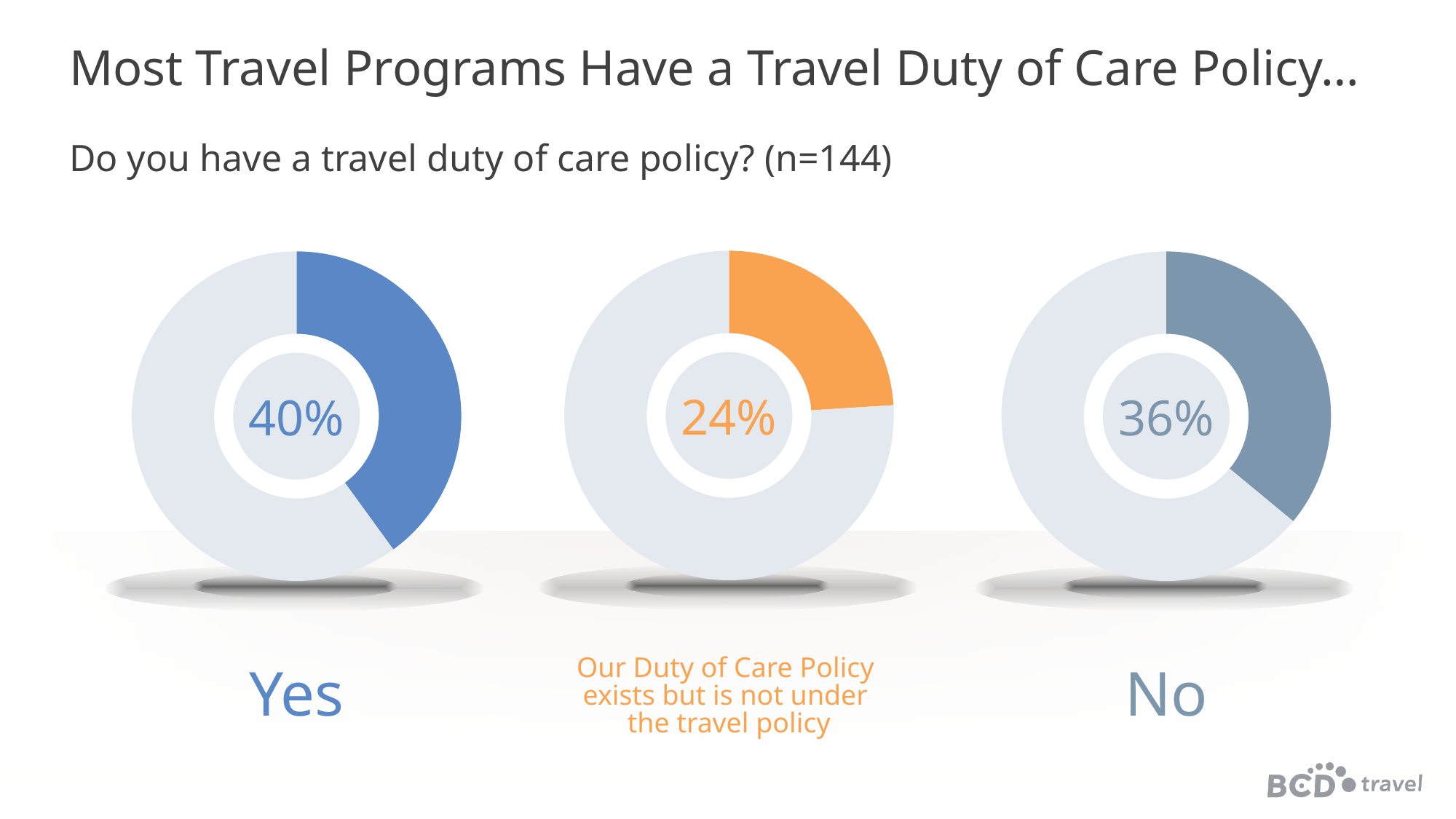
What is the difference in percentage points between the "Yes" and "No" responses? 4 What percentage of respondents answered "Yes" to having a travel duty of care policy? 40% What percentage of respondents answered "No"? 36% How many response options are shown on the slide? 3 What percentage said their Duty of Care Policy exists but is not under the travel policy? 24% What is the difference in percentage points between the "No" response and the "exists but is not under the travel policy" response? 12 Which response option has the highest percentage? Yes What kind of chart is used to show each response? Donut (pie) chart How many respondents (n) answered the survey question? 144 Which is larger, the share answering "Yes" or the share answering "No"? Yes What colour is the segment for the "exists but is not under the travel policy" response? Orange Which response option has the lowest percentage? Our Duty of Care Policy exists but is not under the travel policy